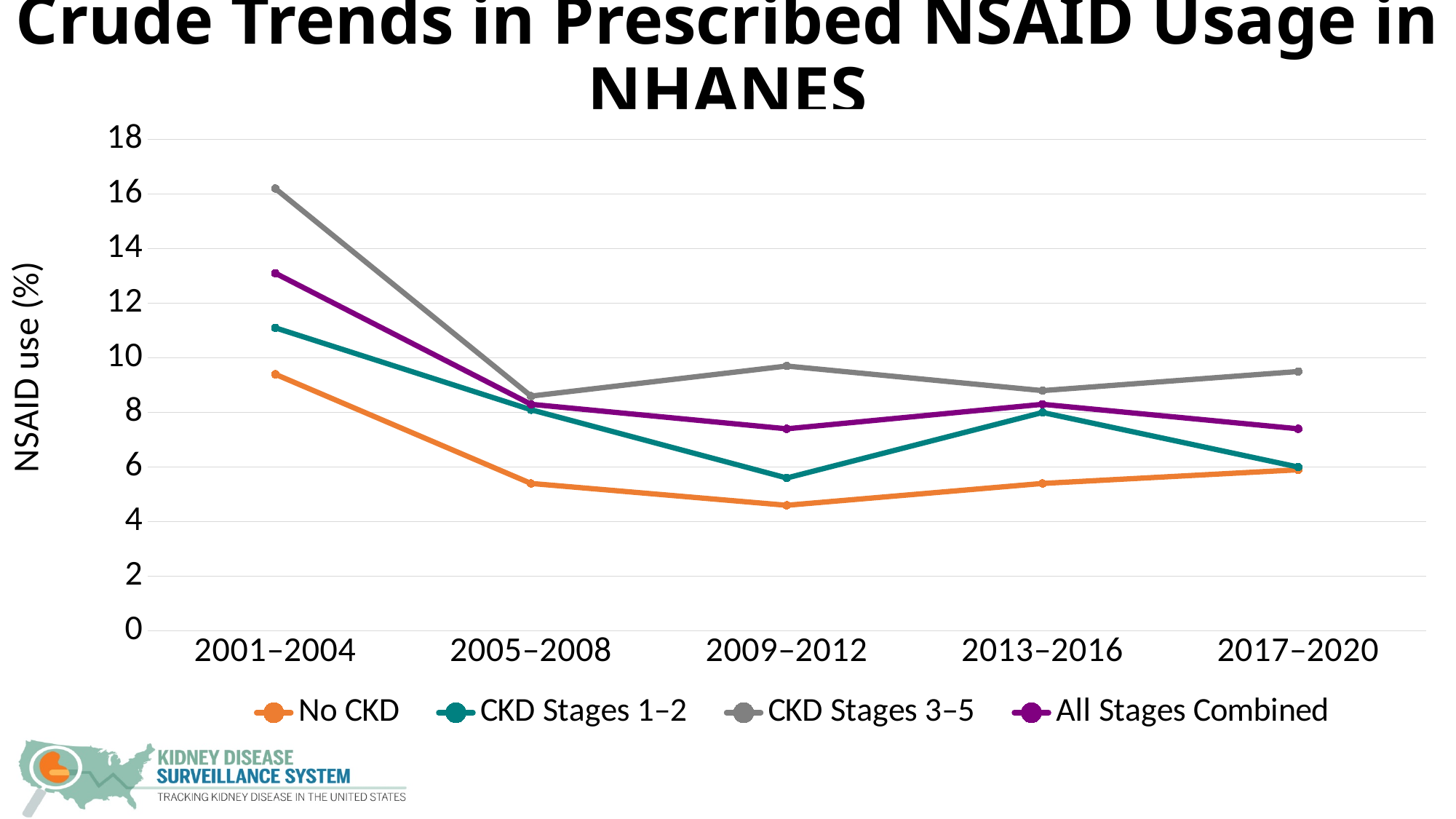
Is the value for No CKD in 2009–2012 greater or less than 6? less Which series has the highest value in 2001–2004? CKD Stages 3–5 Is the value for All Stages Combined in 2001–2004 greater or less than 12? greater In which period is the No CKD value lowest? 2009–2012 How many series does the legend list? 4 Does the No CKD line rise or fall from 2001–2004 to 2009–2012? fall How many time periods are shown on the x axis? 5 Is the value for CKD Stages 3–5 in 2001–2004 greater or less than 14? greater What is the label on the y axis? NSAID use (%) What kind of chart is shown on the slide? line chart In 2009–2012, which is larger: CKD Stages 1–2 or All Stages Combined? All Stages Combined In which period is the No CKD value highest? 2001–2004